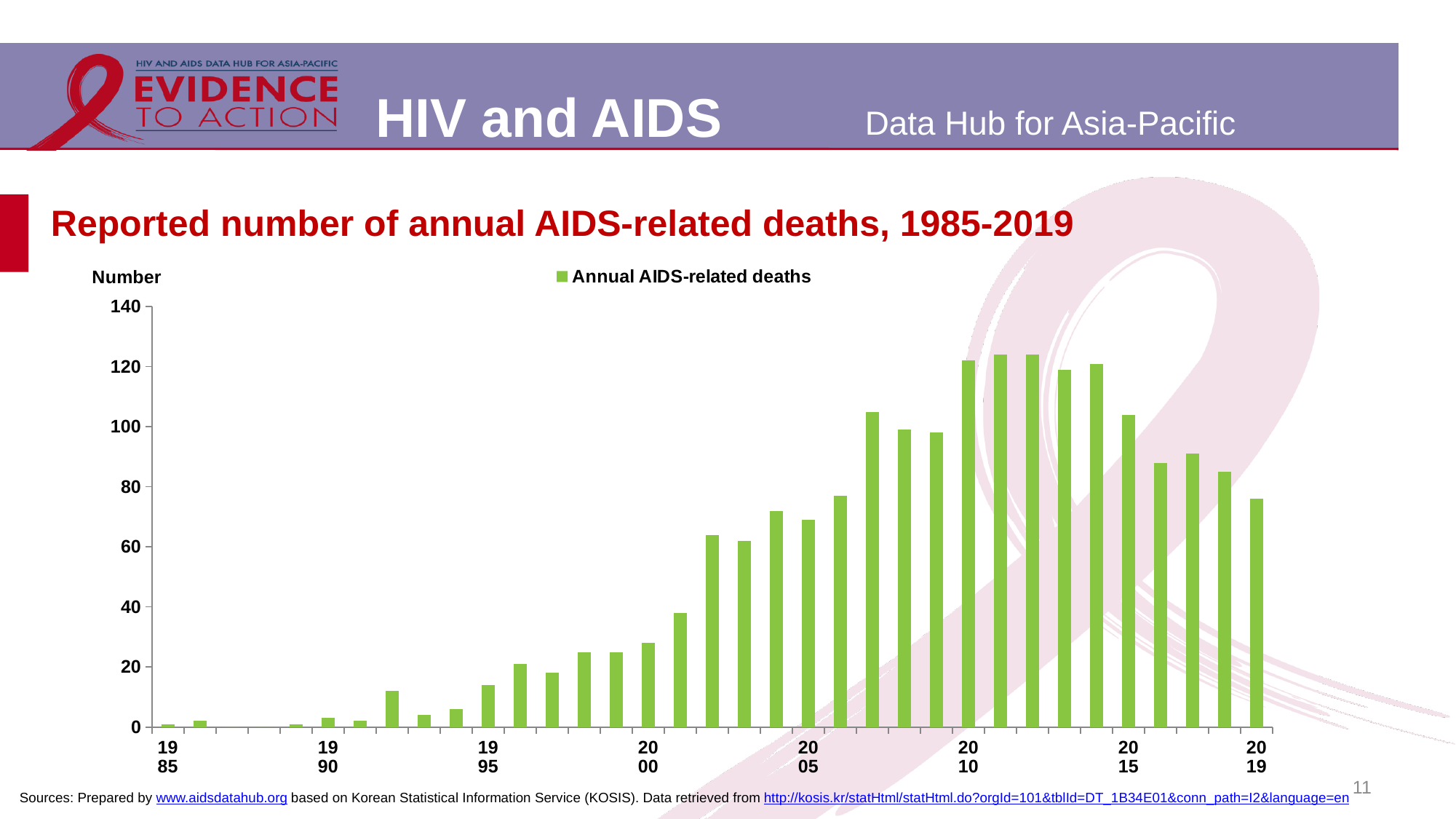
What kind of chart is shown on the slide? bar chart Which year has the larger value, 2010 or 2019? 2010 Is the value for 2000 greater or less than 40? less How many series does the legend list? 1 What is the label on the vertical axis? Number Which year has the larger value, 2005 or 2015? 2015 What is the name of the series shown in the legend? Annual AIDS-related deaths Is the value for 1995 greater or less than 20? less Is the value for 2010 greater or less than 100? greater Do the values generally rise or fall from 1985 to 2010? rise